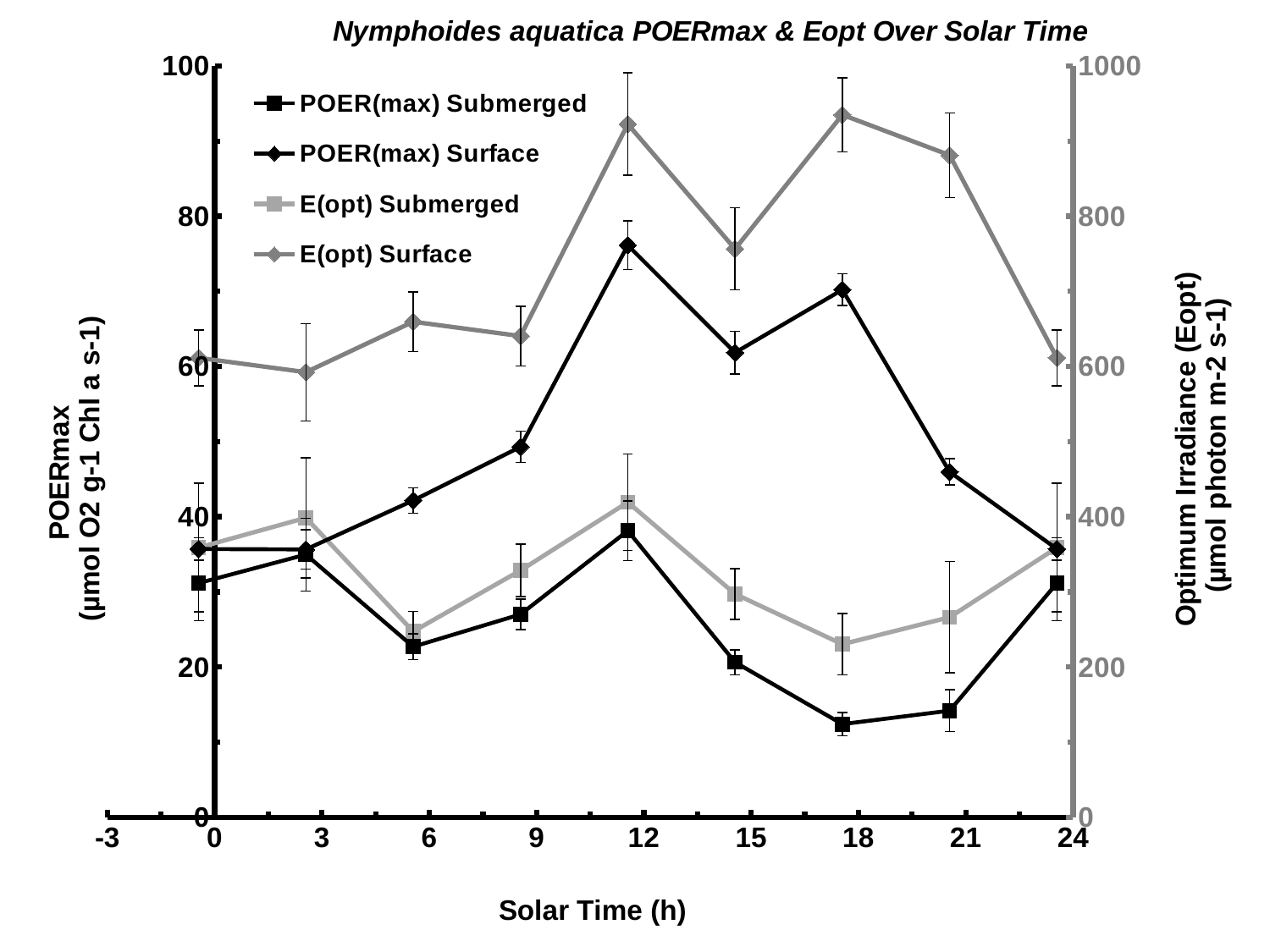
What is the title of the chart? Nymphoides aquatica POERmax & Eopt Over Solar Time What is the x-axis title of the chart? Solar Time (h) Is the value for POER(max) Submerged at the point nearest 18 h greater or less than 20? less At the point nearest 12 h, which is larger: POER(max) Surface or POER(max) Submerged? POER(max) Surface Is the value for POER(max) Surface at the point nearest 12 h greater or less than 60? greater What type of chart is shown on the slide? line chart How many data points are plotted for the POER(max) Surface series? 9 Near which solar time tick does the POER(max) Surface series reach its highest value? 12 Is the value for E(opt) Submerged at the point nearest 18 h greater or less than 400? less How many series does the legend list? 4 Does the E(opt) Surface series rise or fall between the points nearest 21 h and 24 h? fall